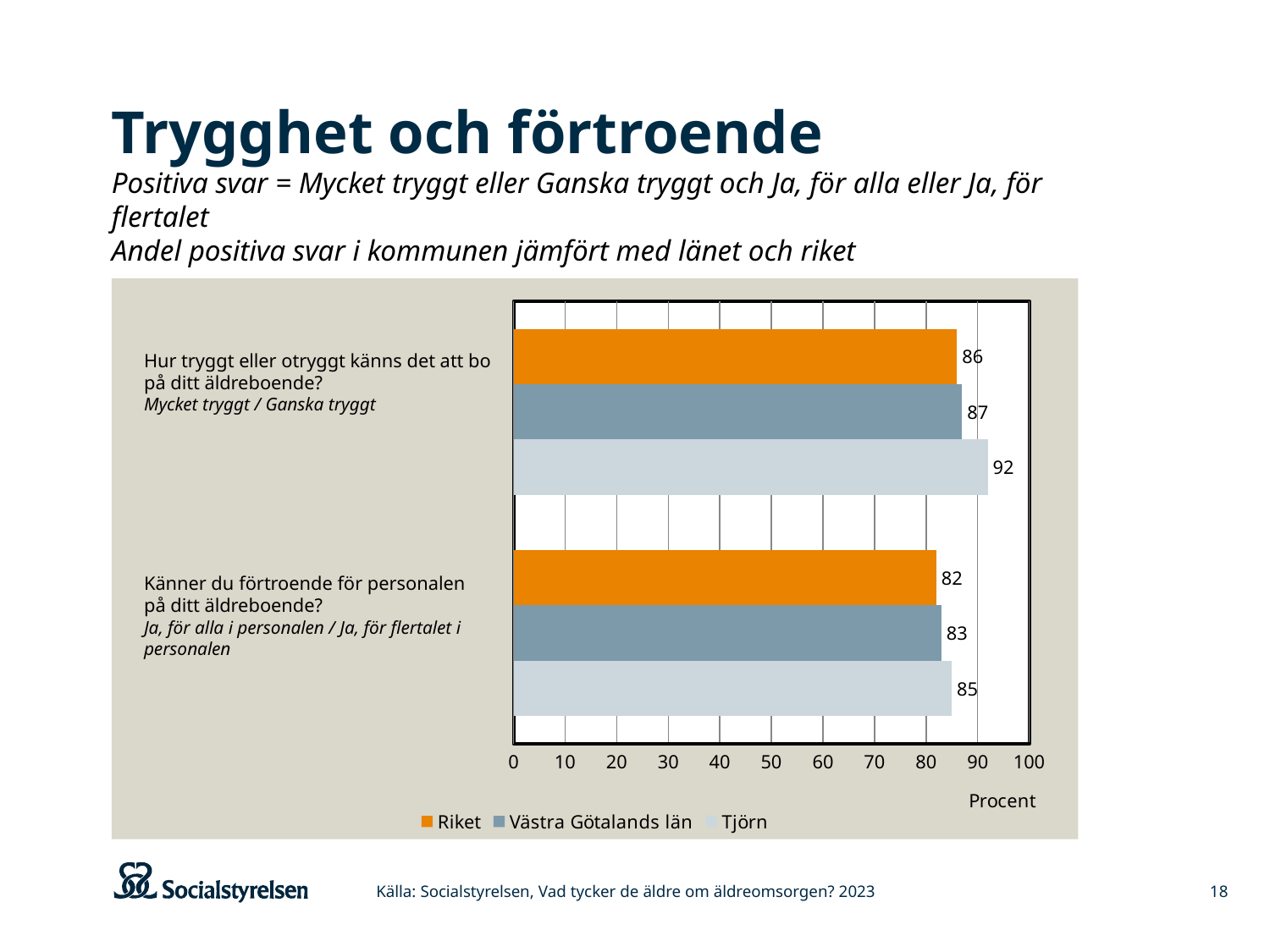
What is the value for Tjörn on the question "Känner du förtroende för personalen på ditt äldreboende?"? 85 What is the value for Tjörn on the question "Hur tryggt eller otryggt känns det att bo på ditt äldreboende?"? 92 What is the difference between Tjörn and Västra Götalands län on the question "Känner du förtroende för personalen på ditt äldreboende?"? 2 What is the difference between Tjörn and Riket on the question "Hur tryggt eller otryggt känns det att bo på ditt äldreboende?"? 6 What is the value for Västra Götalands län on the question "Hur tryggt eller otryggt känns det att bo på ditt äldreboende?"? 87 What kind of chart is shown on the slide? Bar chart Which series has the highest value on the question "Hur tryggt eller otryggt känns det att bo på ditt äldreboende?"? Tjörn Which series has the lowest value on the question "Känner du förtroende för personalen på ditt äldreboende?"? Riket Is the value for Tjörn on the question "Hur tryggt eller otryggt känns det att bo på ditt äldreboende?" greater or less than 90? greater What unit is shown on the x axis of the chart? Procent What is the value for Riket on the question "Känner du förtroende för personalen på ditt äldreboende?"? 82 How many series does the legend list? 3